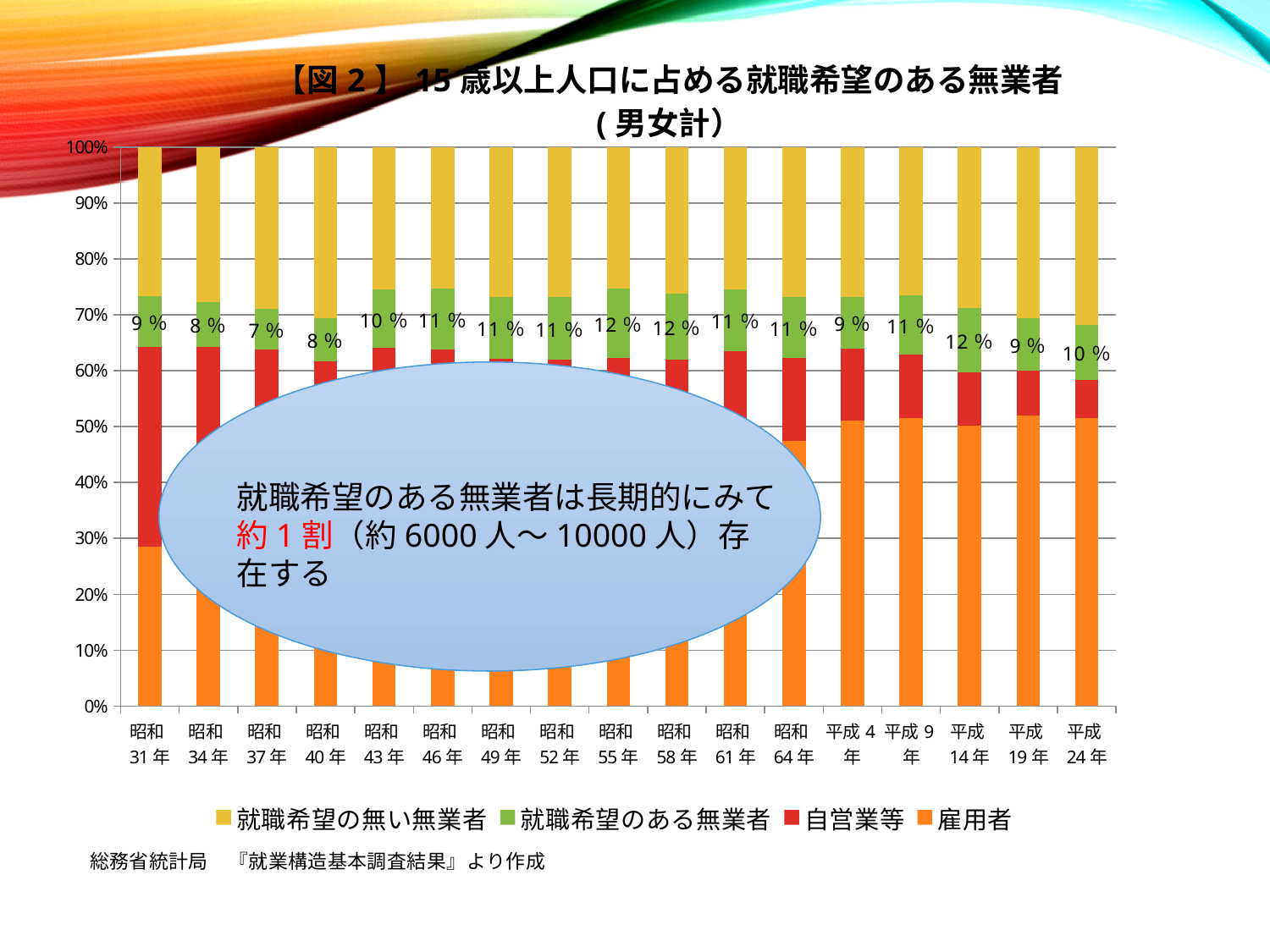
Which is larger, the 就職希望のある無業者 value for 昭和43年 or for 昭和37年? 昭和43年 What is the labelled value for 就職希望のある無業者 in 昭和31年? 9% In which year is the labelled value for 就職希望のある無業者 the lowest? 昭和37年 How many series does the legend list? 4 Which series is listed first in the legend? 就職希望の無い無業者 What is the labelled value for 就職希望のある無業者 in 平成14年? 12% How many year categories are plotted along the x axis? 17 What is the labelled value for 就職希望のある無業者 in 平成24年? 10% What is the difference between the 就職希望のある無業者 values for 昭和55年 and 昭和37年? 5 percentage points What is the labelled value for 就職希望のある無業者 in 昭和37年? 7% Is the 雇用者 share for 昭和31年 greater or less than 30%? less What kind of chart is shown on the slide? Stacked bar chart